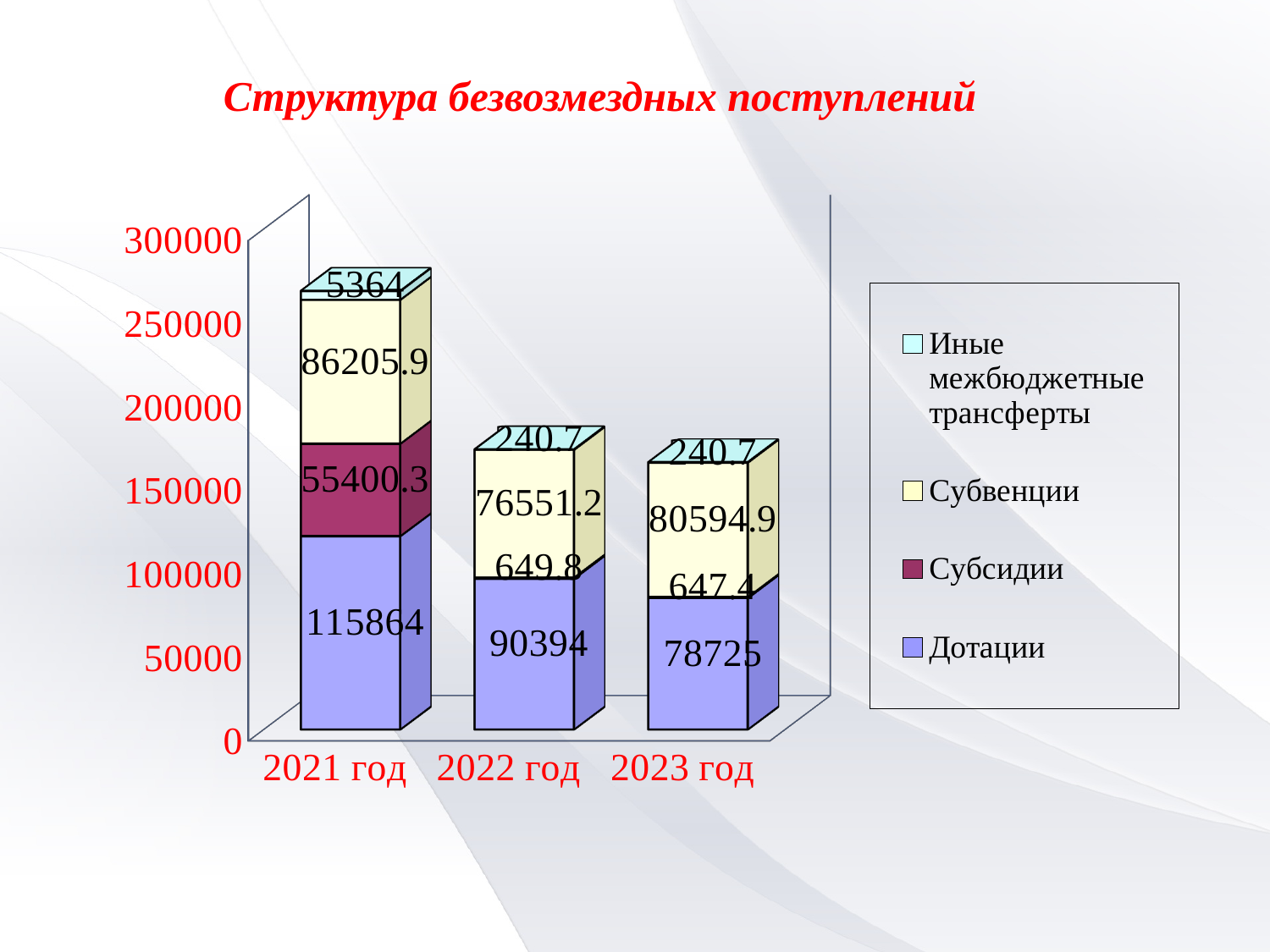
What is the value of Субсидии for 2022 год? 649.8 Which is larger: Субвенции for 2022 год or Субвенции for 2023 год? Субвенции for 2023 год Which year has the lowest value for Субвенции? 2022 год How do the Дотации values change from 2021 год to 2023 год? They fall What is the value of Субвенции for 2023 год? 80594.9 Which year has the highest value for Дотации? 2021 год What kind of chart is shown on the slide? Stacked bar chart What is the difference between the Дотации values for 2021 год and 2022 год? 25470 How many series does the legend list? 4 What is the value of Дотации for 2021 год? 115864 What is the total of the stacked bar for 2022 год? 167835.7 What is the value of Иные межбюджетные трансферты for 2021 год? 5364